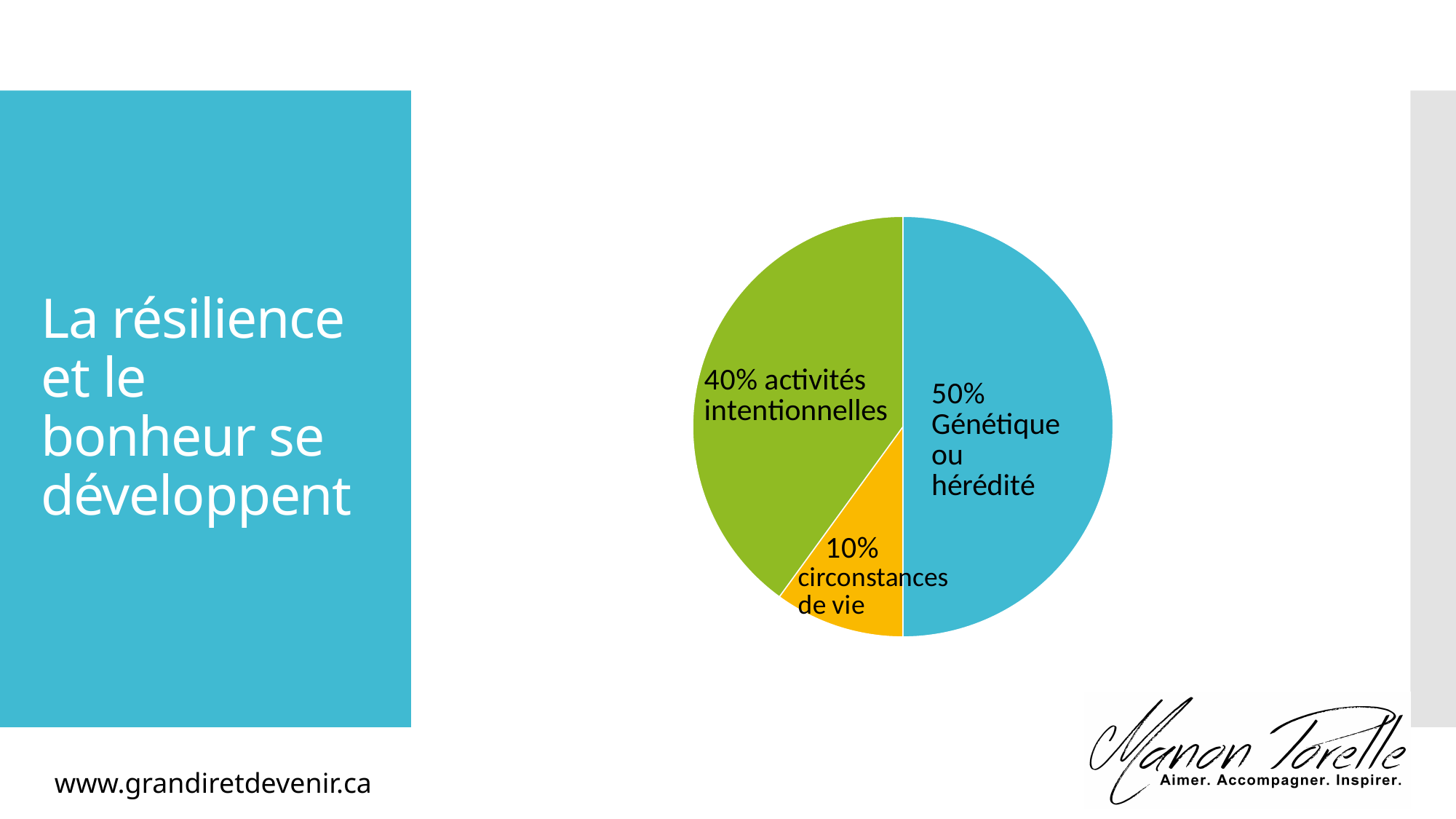
What share of the pie is labelled "activités intentionnelles"? 40% What is the difference between the share for "activités intentionnelles" and the share for "circonstances de vie"? 30% Which is larger: the share for "activités intentionnelles" or the share for "circonstances de vie"? activités intentionnelles How many slices does the pie chart have? 3 What colour is the slice for "circonstances de vie"? orange Which slice of the pie chart is the largest? Génétique ou hérédité What share of the pie is labelled "circonstances de vie"? 10% What colour is the slice for "Génétique ou hérédité"? blue Which slice of the pie chart is the smallest? circonstances de vie What share of the pie is labelled "Génétique ou hérédité"? 50% What is the difference between the share for "Génétique ou hérédité" and the share for "activités intentionnelles"? 10% What kind of chart is shown on the slide? pie chart